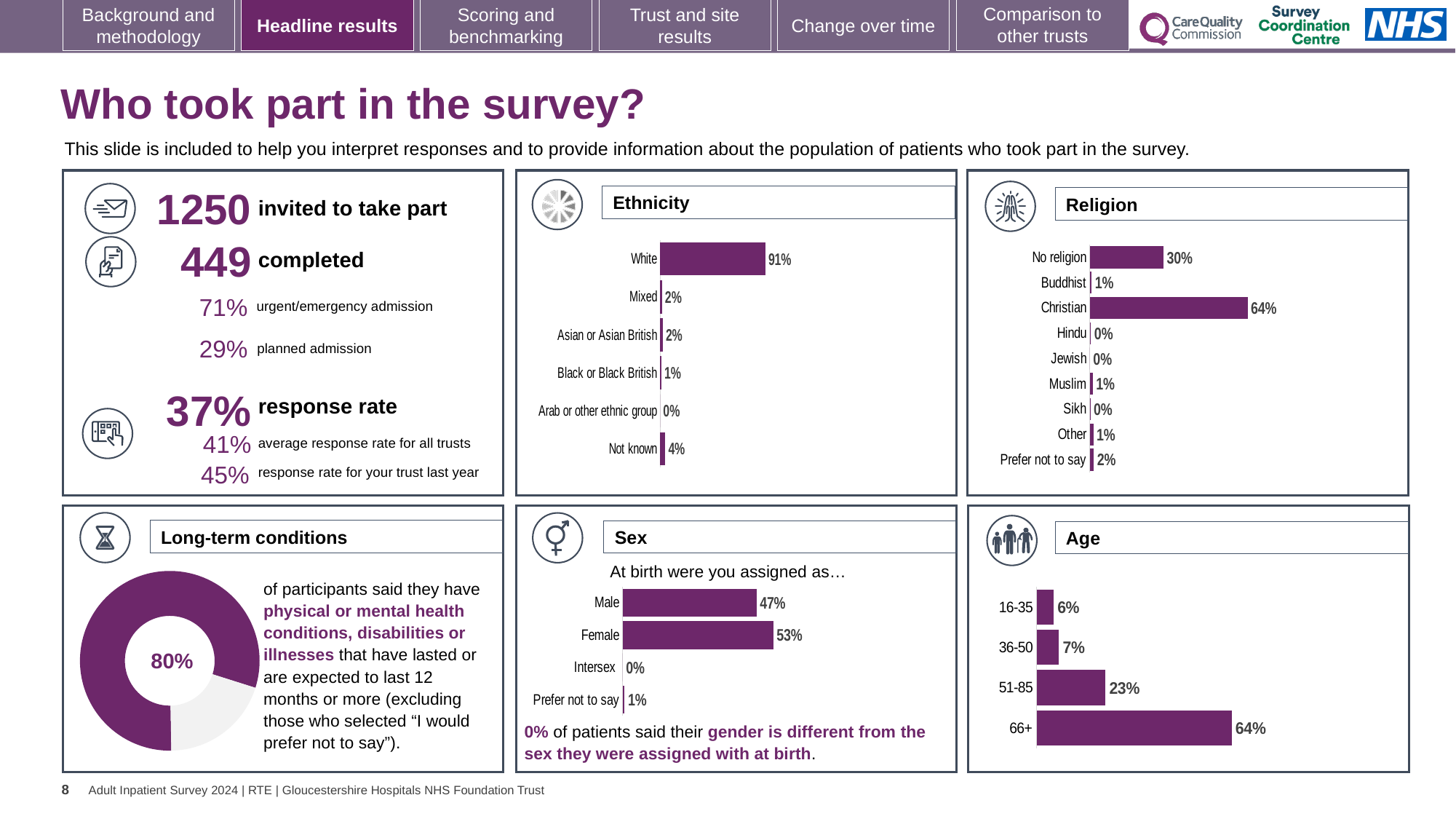
In the Religion chart, which category has the highest value? Christian In the Ethnicity chart, what percentage of participants were White? 91% In the Long-term conditions chart, what share of participants said they have long-term conditions? 80% In the Age chart, do the values rise or fall from 16-35 to 66+? Rise How many categories are shown in the Ethnicity chart? 6 In the Ethnicity chart, which category has the lowest value? Arab or other ethnic group In the Sex chart, what is the value for Prefer not to say? 1% How many categories are shown in the Religion chart? 9 In the Sex chart, which is larger, Male or Female? Female In the Age chart, what is the difference between the 66+ and 51-85 values? 41% In the Religion chart, what is the value for No religion? 30% What kind of chart is the Long-term conditions chart? Doughnut chart